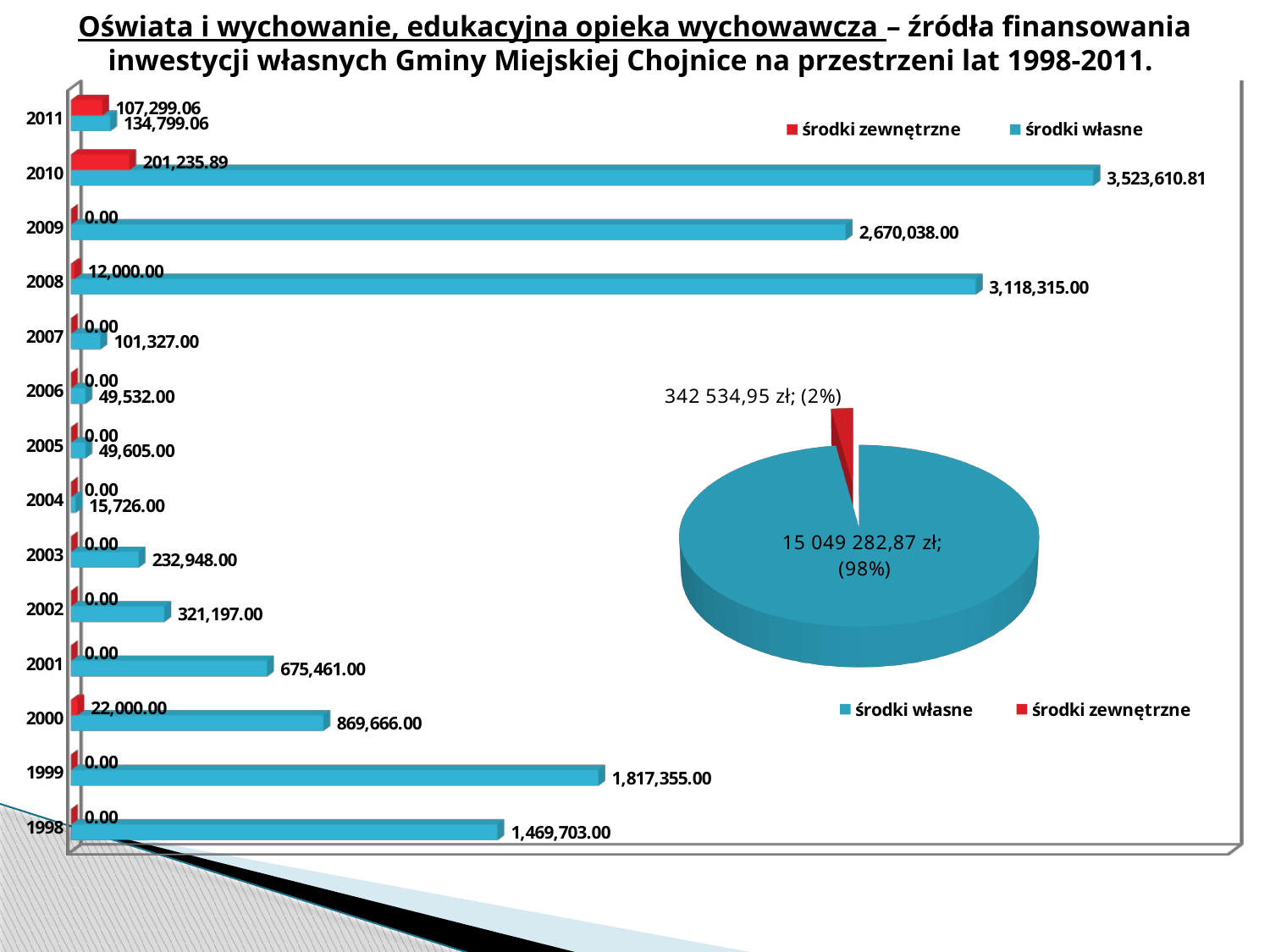
In the pie chart, what share of the total is środki własne? 98% In the bar chart, which year has the highest value of środki zewnętrzne? 2010 How many series does the bar chart legend list? 2 In the bar chart, which is larger for 1999: środki własne in 1999 or środki własne in 1998? środki własne in 1999 In the bar chart, what is the value of środki własne for 2010? 3,523,610.81 In the bar chart, what is the value of środki zewnętrzne for 2008? 12,000.00 In the bar chart, which year has the lowest value of środki własne? 2004 How many years are shown in the bar chart? 14 In the pie chart, what is the value shown for środki zewnętrzne? 342 534,95 zł In the bar chart, what is the value of środki zewnętrzne for 2011? 107,299.06 In the bar chart, which year has the highest value of środki własne? 2010 In the bar chart, what is the difference between środki własne in 2010 and in 2009? 853,572.81